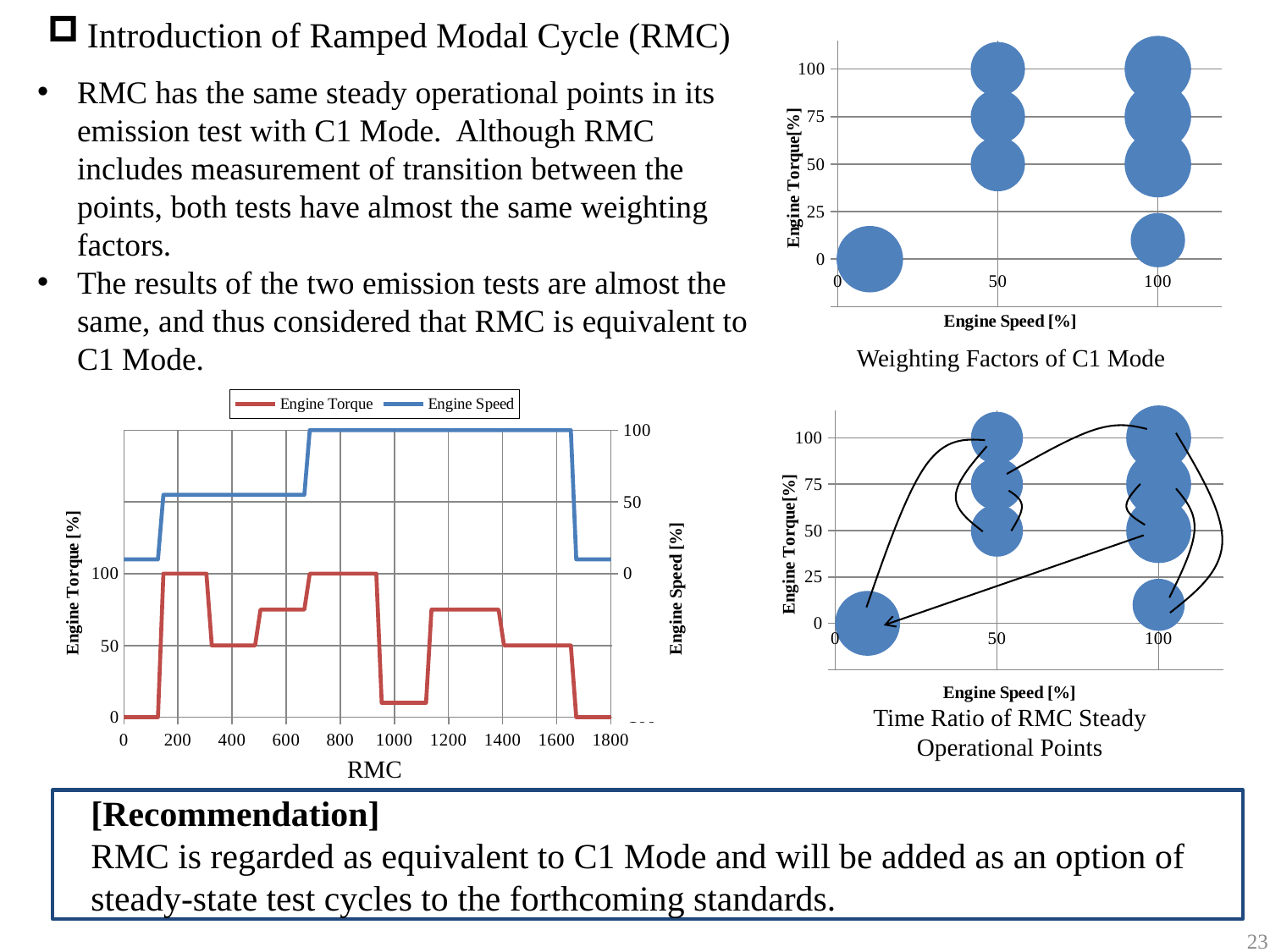
On the RMC chart at the bottom left, does the Engine Speed line rise or fall between RMC 0 and RMC 800? rise On the RMC chart at the bottom left, what is the Engine Speed value at RMC 1000? 100 On the RMC chart at the bottom left, what kind of chart is it? line chart On the Weighting Factors of C1 Mode chart, how many bubbles are plotted? 8 On the Weighting Factors of C1 Mode chart, what is the x-axis title? Engine Speed [%] On the Time Ratio of RMC Steady Operational Points chart, what kind of chart is it? bubble chart On the RMC chart at the bottom left, how many series does the legend list? 2 On the RMC chart at the bottom left, is the Engine Torque value at RMC 1000 greater or less than 50? less On the RMC chart at the bottom left, what is the Engine Torque value at RMC 200? 100 On the RMC chart at the bottom left, what are the two legend entries? Engine Torque, Engine Speed